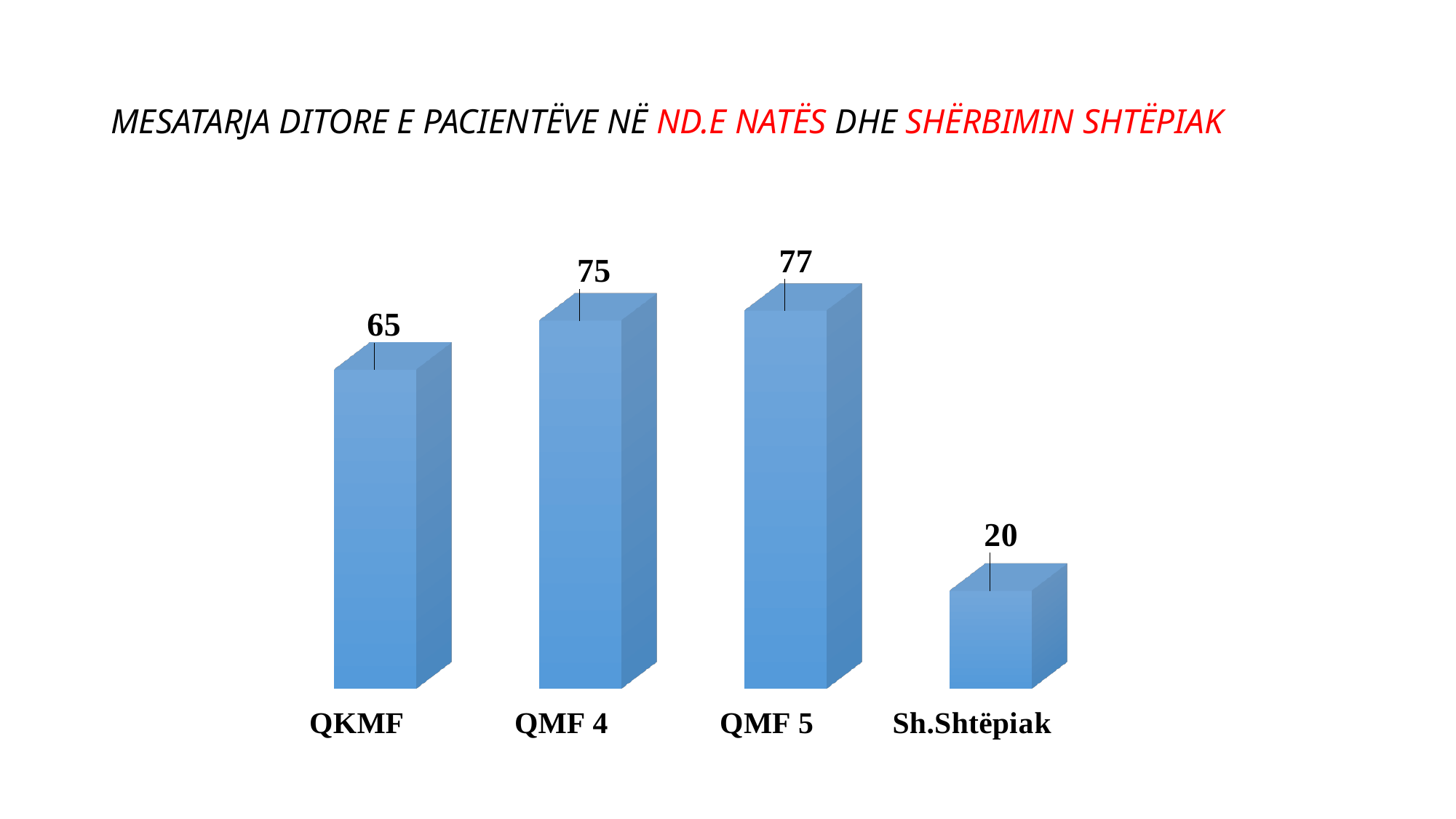
What is the value for Sh.Shtëpiak? 20 What is the difference between the values for QMF 4 and QKMF? 10 What is the value for QMF 5? 77 What is the value for QMF 4? 75 What is the title of the slide? MESATARJA DITORE E PACIENTËVE NË ND.E NATËS DHE SHËRBIMIN SHTËPIAK Which category has the lowest value? Sh.Shtëpiak What is the value for QKMF? 65 What is the difference between the values for QMF 5 and Sh.Shtëpiak? 57 What kind of chart is shown on the slide? bar chart Which category has the highest value? QMF 5 How many categories are shown in the chart? 4 Which is larger, the value for QKMF or the value for Sh.Shtëpiak? QKMF